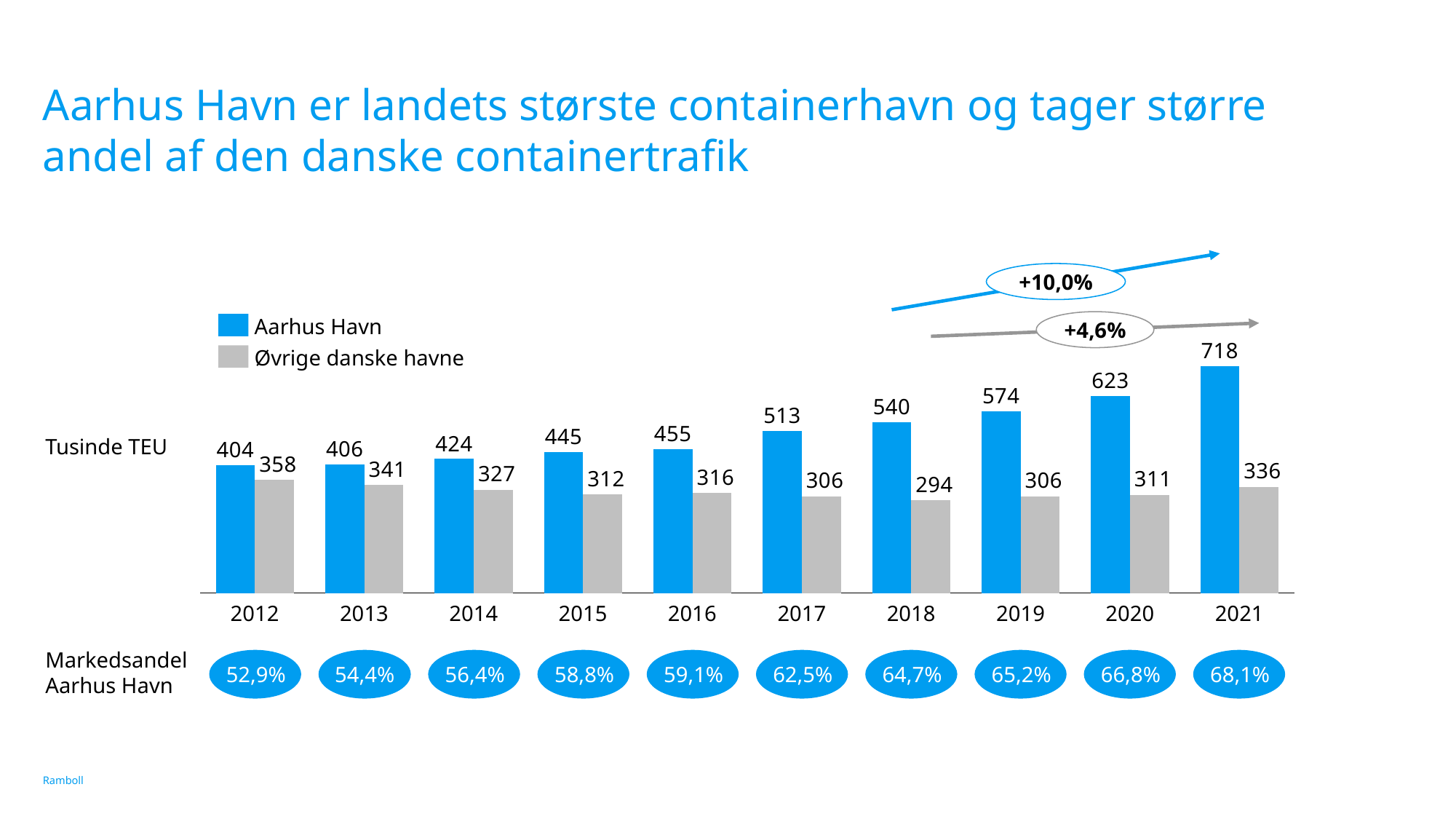
Which is larger in 2012: the Aarhus Havn value or the Øvrige danske havne value? Aarhus Havn In which year is the Øvrige danske havne value lowest? 2018 What is the value for Øvrige danske havne in 2018? 294 How many series does the legend list? 2 What is the value for Aarhus Havn in 2021? 718 Do the Aarhus Havn values rise or fall from 2012 to 2021? Rise What unit label is shown next to the chart's y axis? Tusinde TEU What is the Markedsandel Aarhus Havn shown for 2017? 62,5% What is the difference between the Aarhus Havn value and the Øvrige danske havne value in 2021? 382 In which year is the Aarhus Havn value highest? 2021 What kind of chart is shown on the slide? Bar chart How many years are shown on the x axis? 10